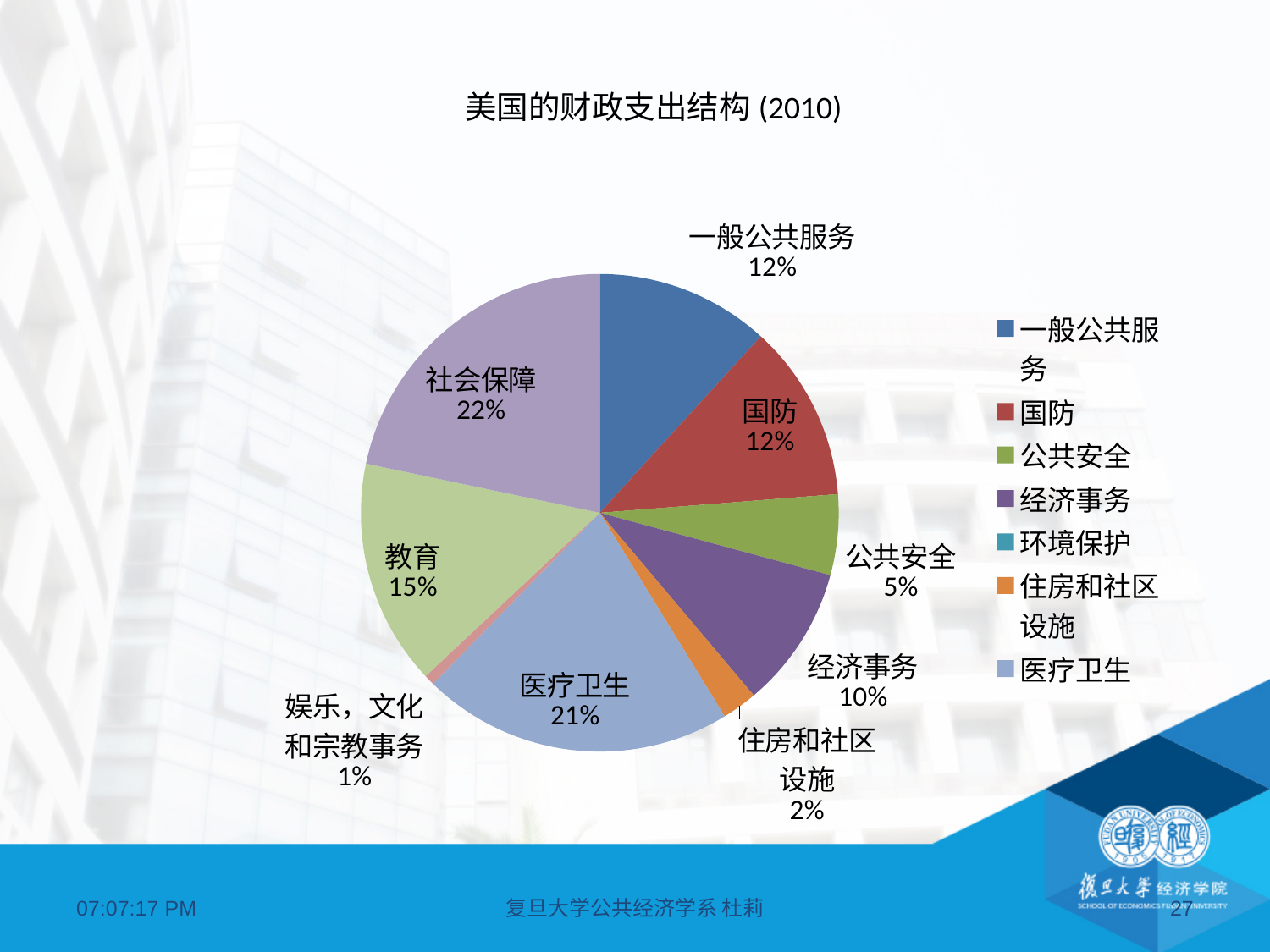
Which is larger, the share for 教育 or the share for 国防? 教育 What colour is the 国防 slice in the pie chart? red What percentage is shown for 医疗卫生? 21% What type of chart is shown on the slide? pie chart What percentage is shown for 教育? 15% What share of the pie does 社会保障 account for? 22% Which category has the largest share of the pie? 社会保障 What is the title of the chart? 美国的财政支出结构 (2010) Which labelled category has the smallest share of the pie? 娱乐，文化和宗教事务 What is the difference in percentage points between 教育 and 经济事务? 5% What percentage is shown for 住房和社区设施? 2% What is the difference in percentage points between 社会保障 and 医疗卫生? 1%